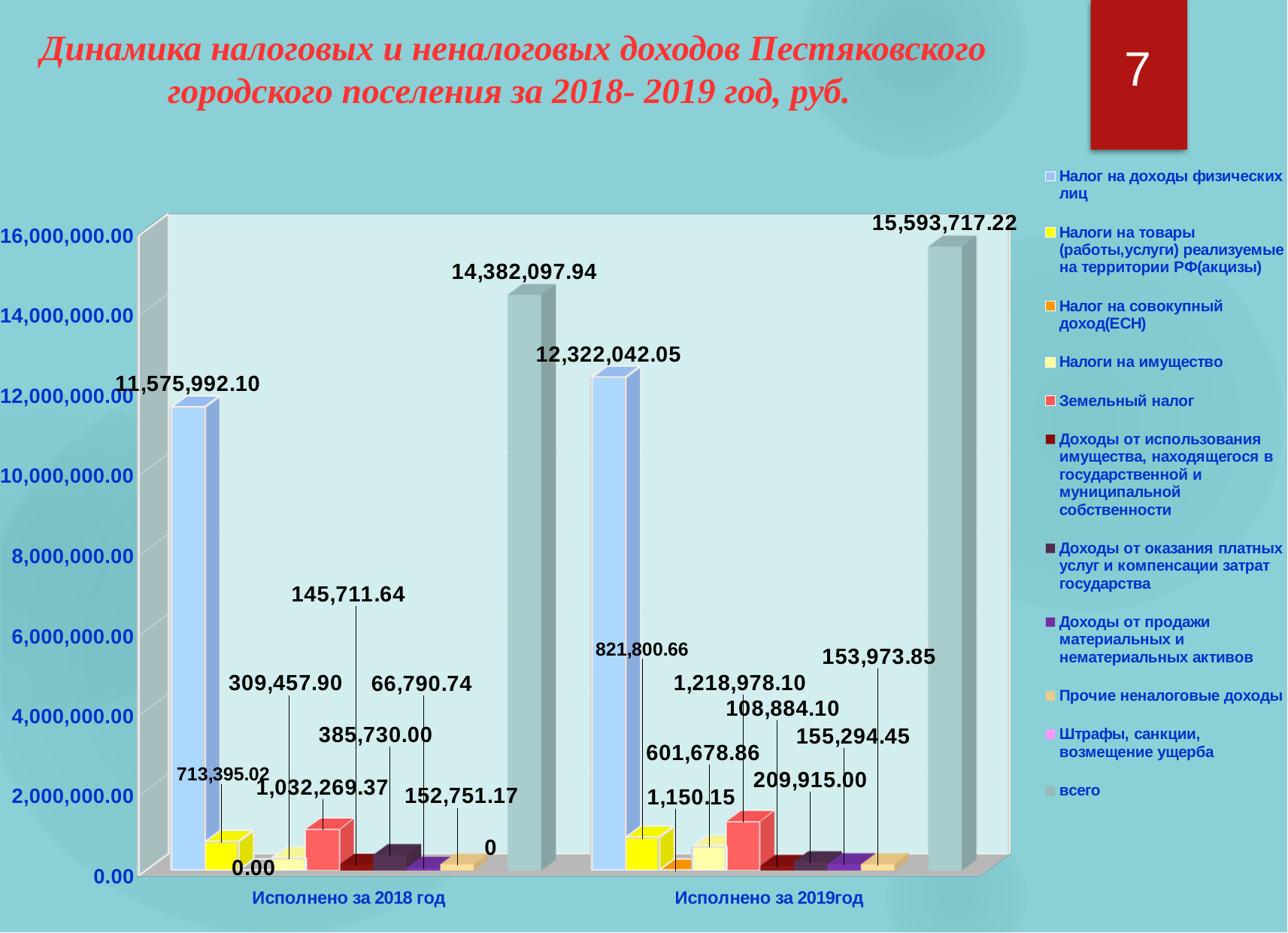
Does the value of 'всего' rise or fall from 2018 to 2019? Rises What is the value of 'Налог на доходы физических лиц' for 'Исполнено за 2018 год'? 11,575,992.10 What kind of chart is shown on the slide? Bar chart What is the difference in 'Налог на доходы физических лиц' between 'Исполнено за 2019год' and 'Исполнено за 2018 год'? 746,049.95 Which year has the larger value for 'Земельный налог', 2018 or 2019? 2019 What is the value of 'Налог на совокупный доход(ЕСН)' for 'Исполнено за 2019год'? 1,150.15 What is the value of 'всего' for 'Исполнено за 2019год'? 15,593,717.22 How many series does the chart legend list? 11 How many categories are shown on the x axis of the chart? 2 Apart from 'всего', which series has the tallest bar for 'Исполнено за 2019год'? Налог на доходы физических лиц What is the value of 'Налоги на имущество' for 'Исполнено за 2019год'? 601,678.86 By how much did 'всего' increase from 'Исполнено за 2018 год' to 'Исполнено за 2019год'? 1,211,619.28